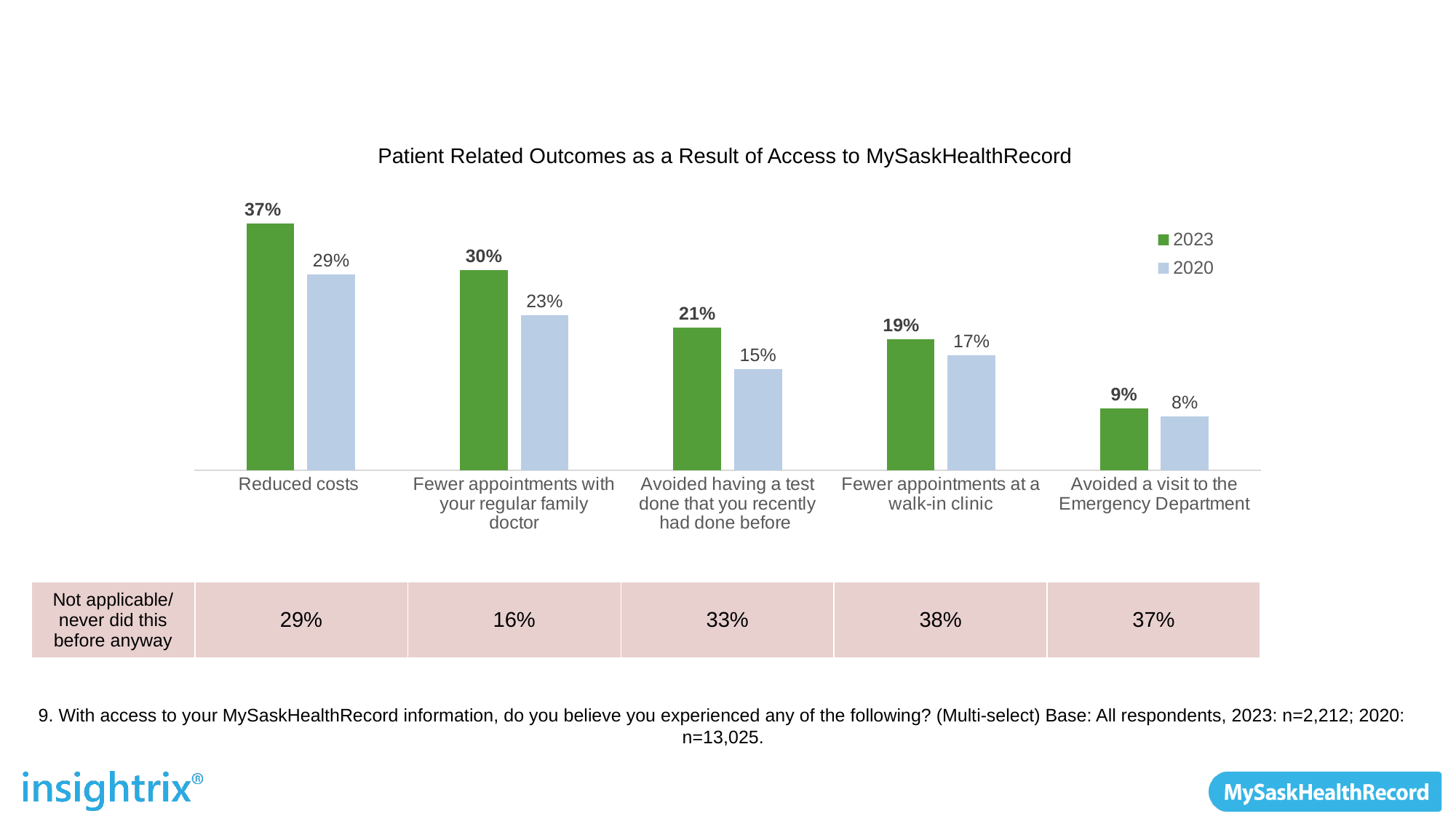
How many series does the legend list? 2 Which category has the highest 2023 value? Reduced costs What is the 2020 value for Avoided having a test done that you recently had done before? 15% What kind of chart is shown on the slide? Bar chart What is the difference between the 2023 and 2020 values for Fewer appointments with your regular family doctor? 7% How many categories are shown on the x axis of the chart? 5 What is the 2023 value for Reduced costs? 37% What is the title of the chart? Patient Related Outcomes as a Result of Access to MySaskHealthRecord What is the 2023 value for Fewer appointments at a walk-in clinic? 19% Which category has the lowest 2020 value? Avoided a visit to the Emergency Department Which is larger for Avoided a visit to the Emergency Department: the 2023 value or the 2020 value? 2023 Do the 2023 values rise or fall moving from left to right across the categories? Fall